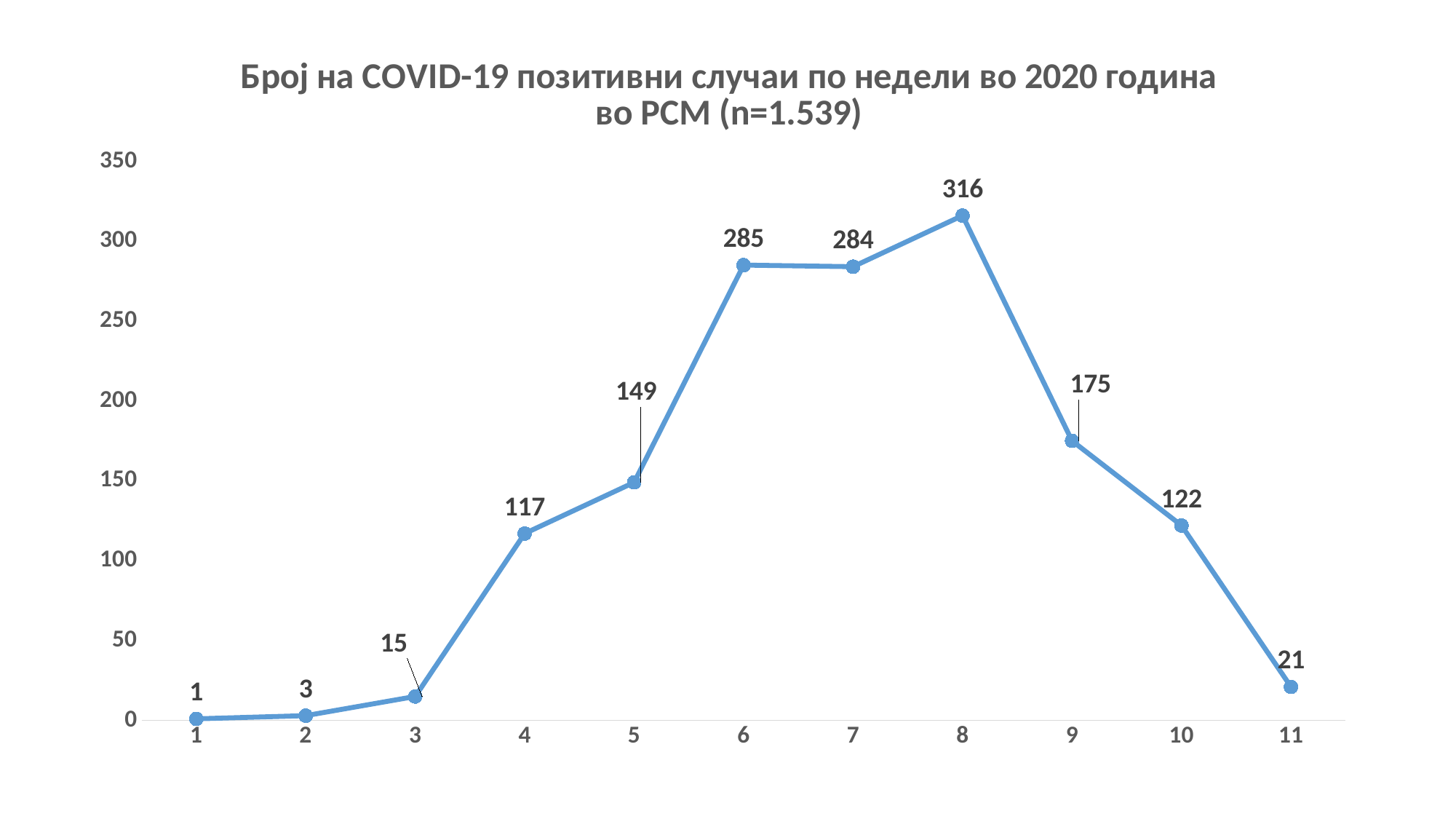
What kind of chart is shown on the slide? line chart What is the difference between the values for week 10 and week 11? 101 What is the value plotted for week 3? 15 What is the difference between the values for week 8 and week 7? 32 What is the value plotted for week 9? 175 Do the values rise or fall from week 8 to week 11? fall Which week has the lowest number of cases? 1 Which week has the highest number of cases? 8 Is the value for week 5 greater or less than 100? greater What is the number of COVID-19 positive cases in week 6? 285 How many weeks are plotted on the x axis? 11 Which is larger, the value for week 4 or the value for week 9? week 9